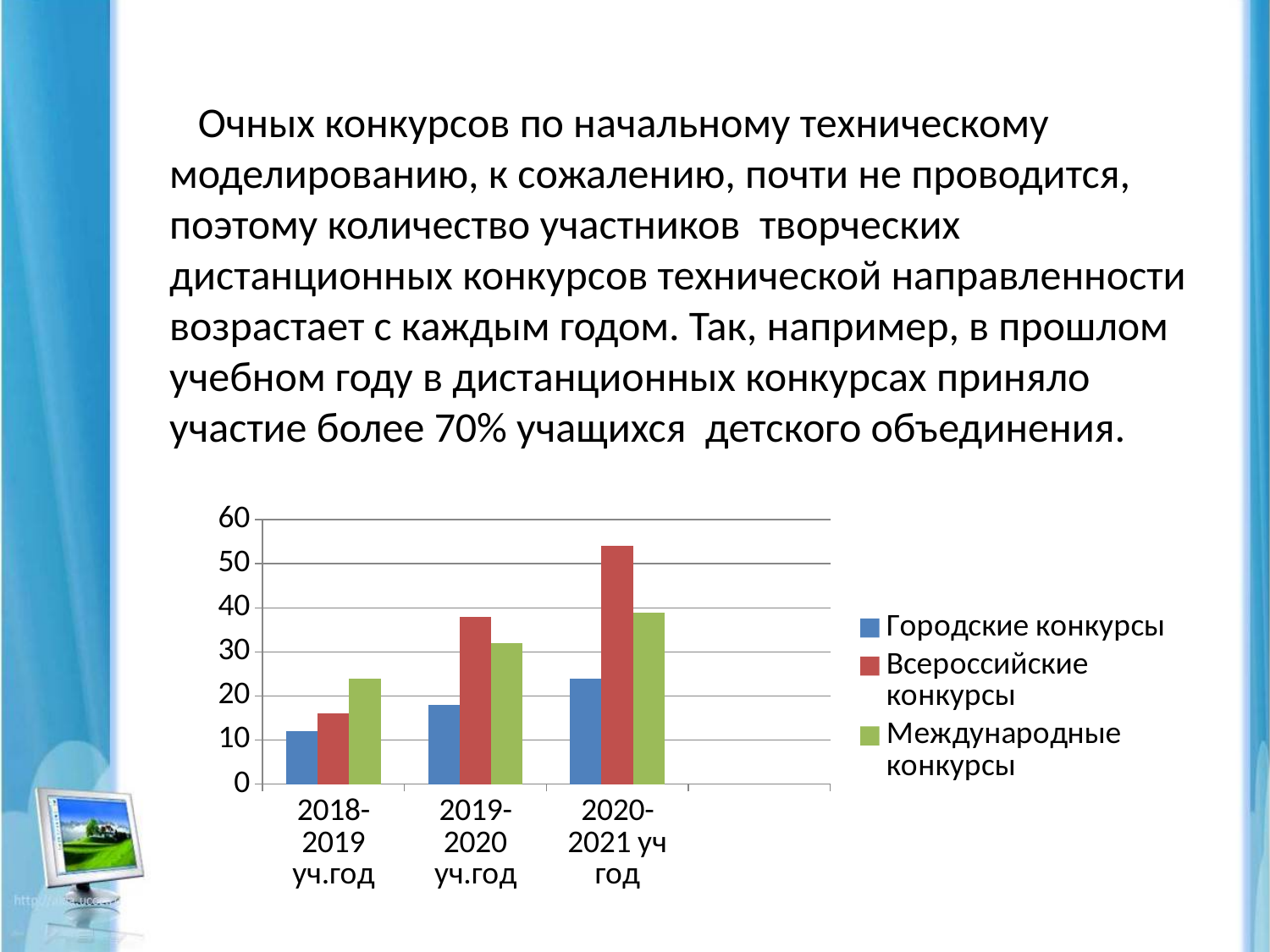
Is the value for Международные конкурсы in 2019-2020 уч.год greater or less than 30? greater How many academic years (categories) are shown on the x axis of the chart? 3 Which series has the tallest bar in the 2018-2019 уч.год category? Международные конкурсы Which series has the shortest bar in the 2019-2020 уч.год category? Городские конкурсы Do the values for Городские конкурсы rise or fall from 2018-2019 уч.год to 2020-2021 уч год? rise Which series has the tallest bar in the 2020-2021 уч год category? Всероссийские конкурсы What colour are the bars for Международные конкурсы in the chart? green Is the value for Городские конкурсы in 2018-2019 уч.год greater or less than 20? less Is the value for Всероссийские конкурсы in 2020-2021 уч год greater or less than 50? greater What kind of chart is shown on the slide? bar chart Which is larger: Всероссийские конкурсы in 2019-2020 уч.год or Международные конкурсы in 2019-2020 уч.год? Всероссийские конкурсы How many series does the chart legend list? 3